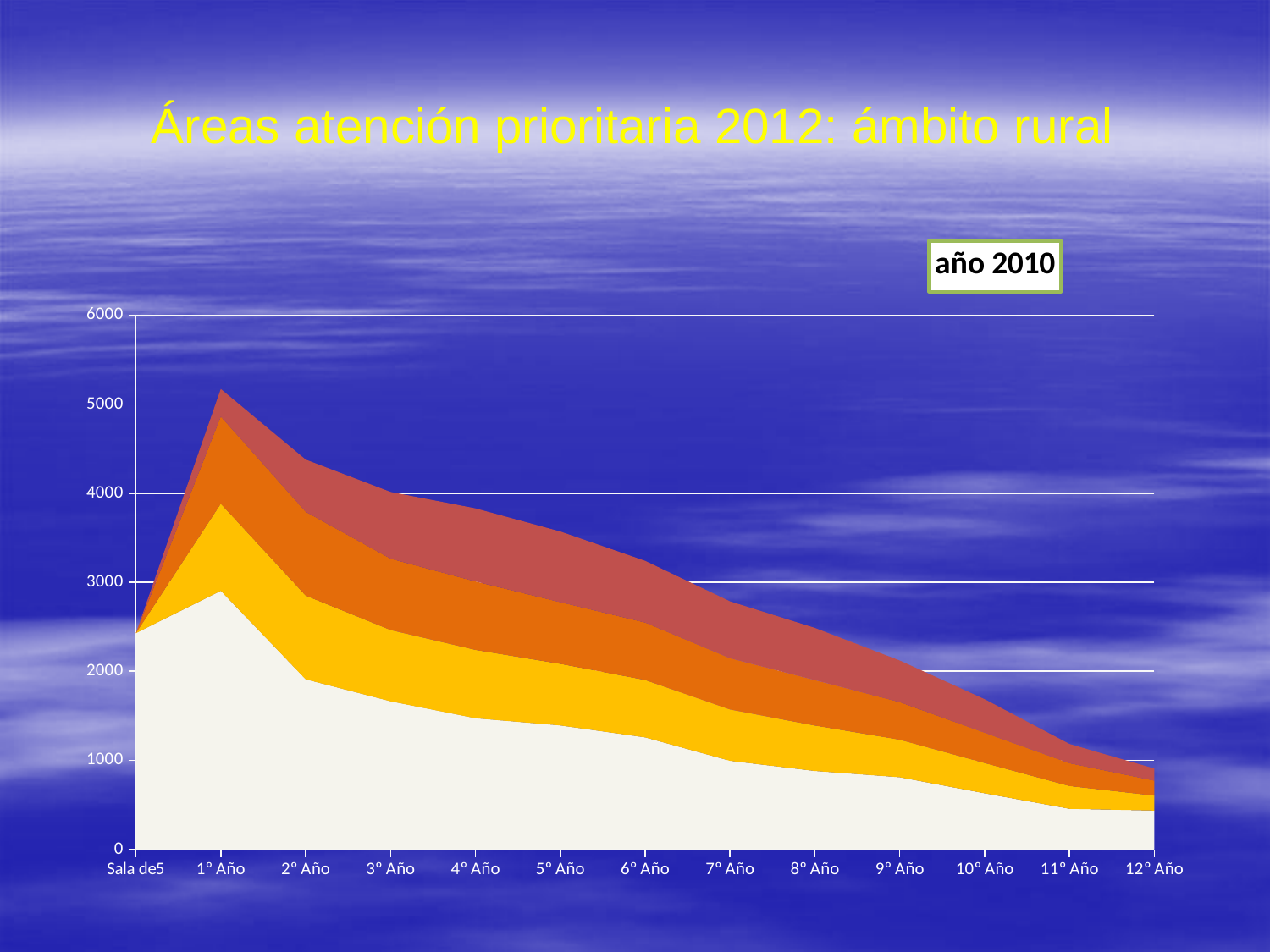
What kind of chart is shown on the slide? area chart Is the stacked total for 8° Año greater or less than 3000? less Which has the larger stacked total, 2° Año or 8° Año? 2° Año At which category does the stacked total reach its highest point? 1° Año How many categories are shown along the x axis of the chart? 13 Is the stacked total for 2° Año greater or less than 4000? greater Is the stacked total for 12° Año greater or less than 1000? less What is the title of the slide containing the chart? Áreas atención prioritaria 2012: ámbito rural From 1° Año to 12° Año, do the stacked totals rise or fall along the x axis? fall At which category is the stacked total lowest? 12° Año What year is shown in the text box above the chart? año 2010